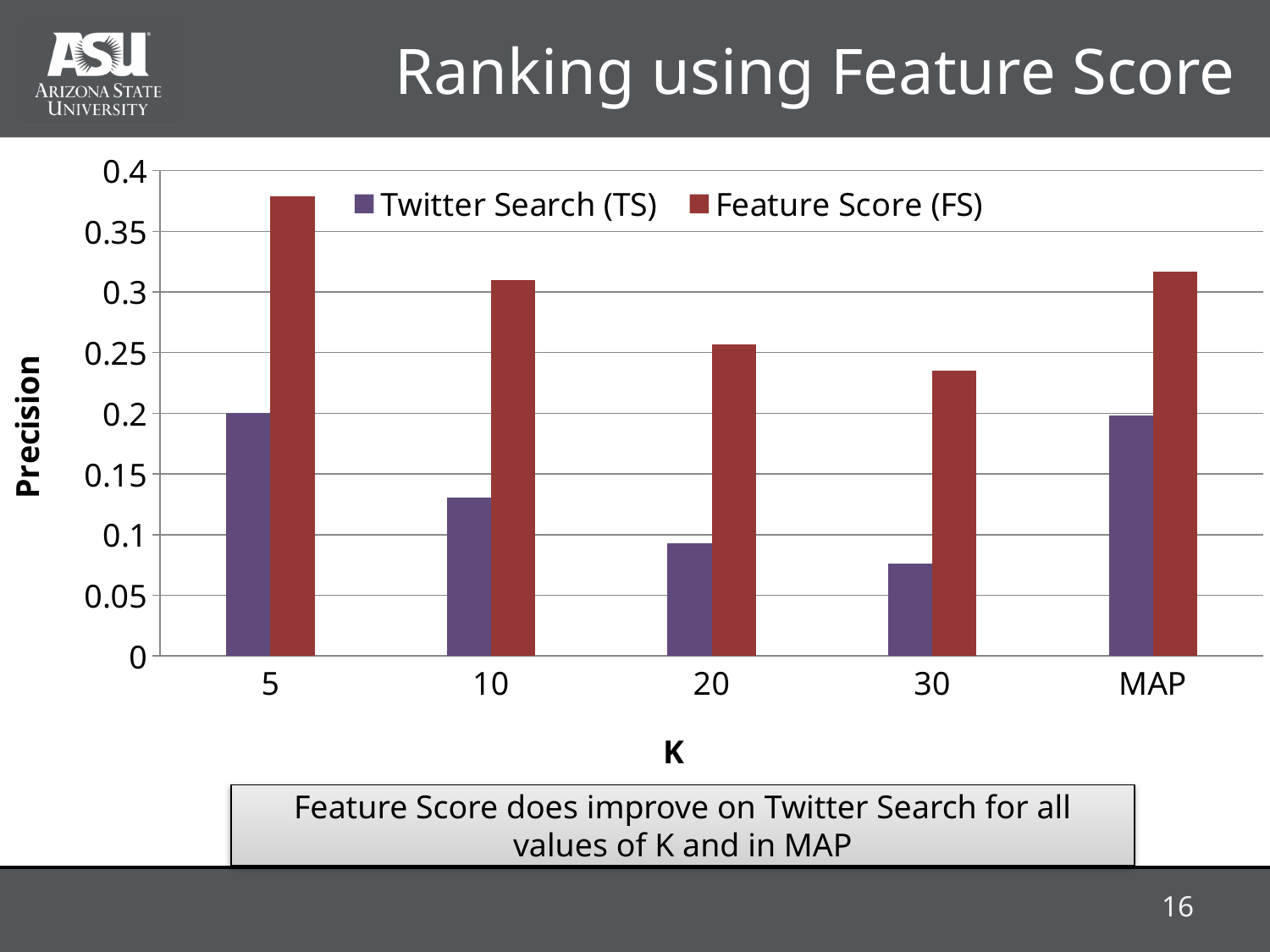
Is the Feature Score (FS) precision at K = 5 greater or less than 0.35? greater What kind of chart is shown on the slide? bar chart At K = 10, which series has the higher precision, Twitter Search (TS) or Feature Score (FS)? Feature Score (FS) Is the Feature Score (FS) precision at K = 30 greater or less than 0.25? less For which K value is the Feature Score (FS) precision highest? 5 How many series does the legend list? 2 Is the Twitter Search (TS) precision at K = 10 greater or less than 0.15? less What is the label of the x axis? K What is the label of the y axis? Precision How many categories are shown on the x axis? 5 For which K value is the Twitter Search (TS) precision lowest? 30 Does the Twitter Search (TS) precision rise or fall as K increases from 5 to 30? fall